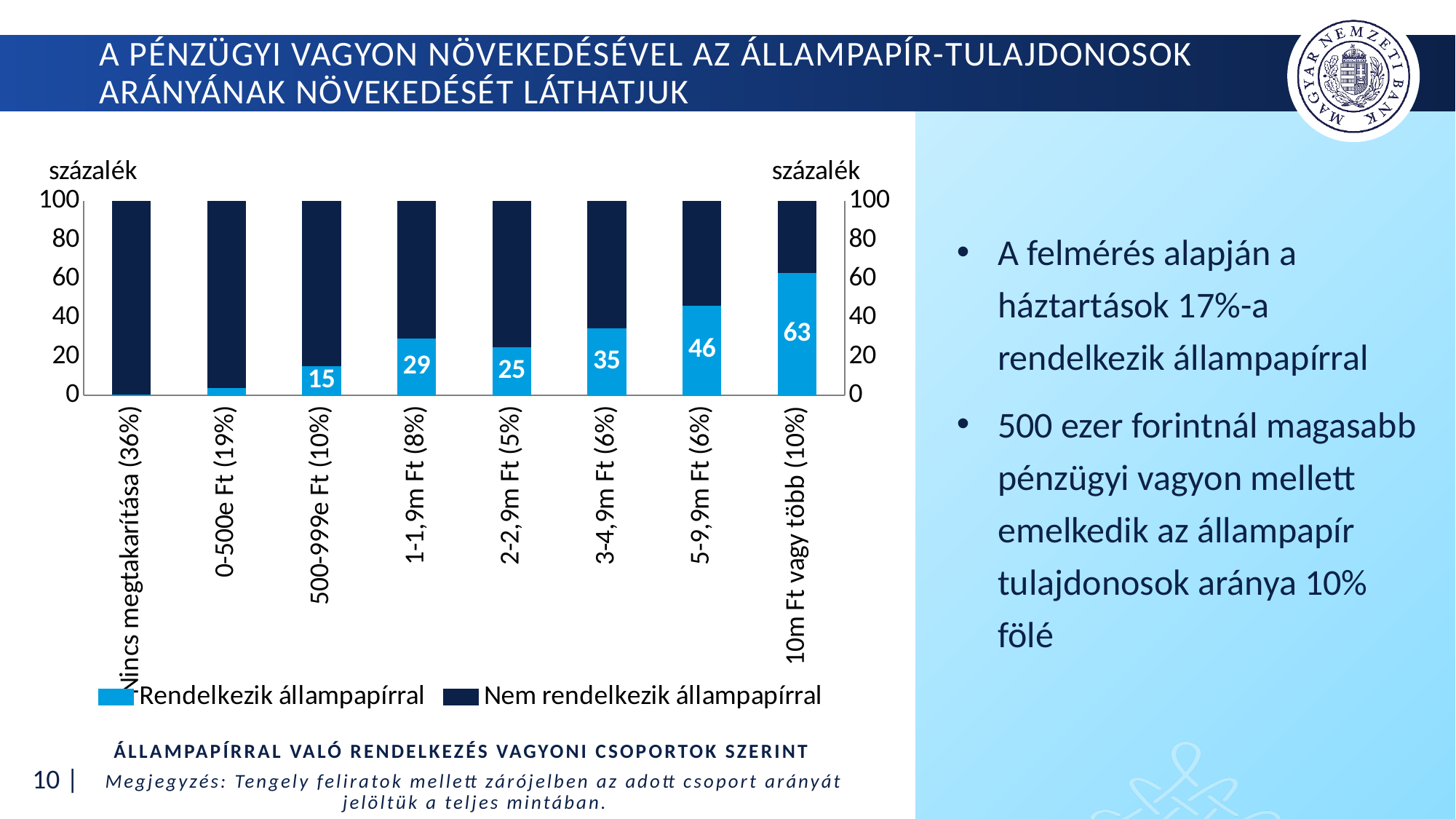
Is the 'Rendelkezik állampapírral' value for '0-500e Ft (19%)' greater or less than 20? less How many series does the chart legend list? 2 What is the title of the chart shown below the legend? ÁLLAMPAPÍRRAL VALÓ RENDELKEZÉS VAGYONI CSOPORTOK SZERINT What is the value for 'Rendelkezik állampapírral' in the '10m Ft vagy több (10%)' category? 63 Which is larger, the 'Rendelkezik állampapírral' value for '1-1,9m Ft (8%)' or for '2-2,9m Ft (5%)'? 1-1,9m Ft (8%) Which category has the highest value for 'Rendelkezik állampapírral'? 10m Ft vagy több (10%) What kind of chart is shown on the slide? Stacked bar chart How many categories are shown on the x axis of the chart? 8 What is the difference between the 'Rendelkezik állampapírral' values for '10m Ft vagy több (10%)' and '5-9,9m Ft (6%)'? 17 What is the value for 'Rendelkezik állampapírral' in the '500-999e Ft (10%)' category? 15 What is the value for 'Rendelkezik állampapírral' in the '3-4,9m Ft (6%)' category? 35